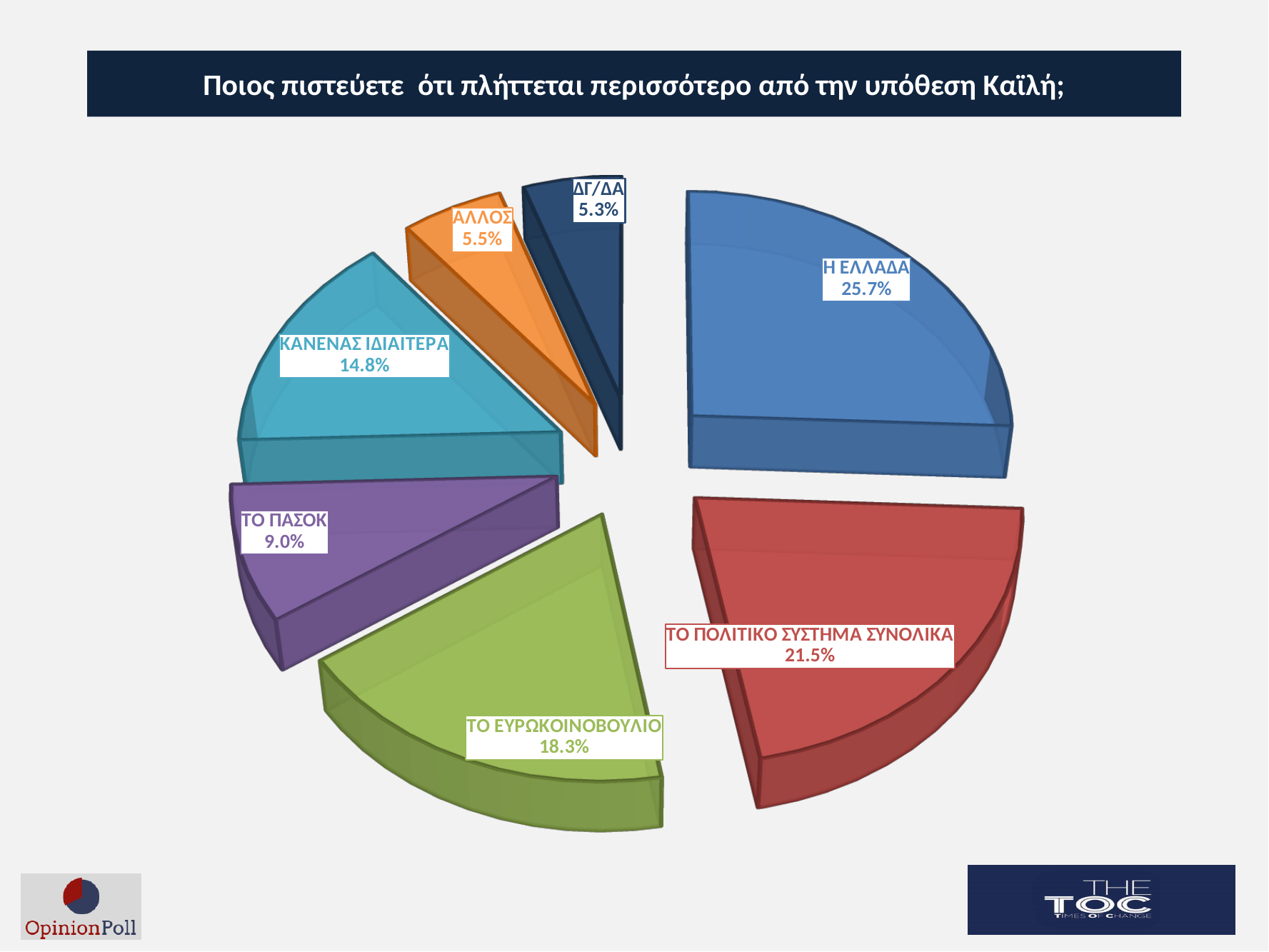
Which is larger, the slice for ΑΛΛΟΣ or the slice for ΔΓ/ΔΑ? ΑΛΛΟΣ What kind of chart is shown on the slide? Pie chart What percentage of the pie is labelled for Η ΕΛΛΑΔΑ? 25.7% What value is shown for ΤΟ ΕΥΡΩΚΟΙΝΟΒΟΥΛΙΟ? 18.3% How many slices does the pie chart have? 7 What share of the pie does ΤΟ ΠΟΛΙΤΙΚΟ ΣΥΣΤΗΜΑ ΣΥΝΟΛΙΚΑ represent? 21.5% Which category has the smallest slice of the pie? ΔΓ/ΔΑ Which category has the largest slice of the pie? Η ΕΛΛΑΔΑ What is the difference in percentage points between ΤΟ ΕΥΡΩΚΟΙΝΟΒΟΥΛΙΟ and ΚΑΝΕΝΑΣ ΙΔΙΑΙΤΕΡΑ? 3.5 What is the difference in percentage points between Η ΕΛΛΑΔΑ and ΤΟ ΠΟΛΙΤΙΚΟ ΣΥΣΤΗΜΑ ΣΥΝΟΛΙΚΑ? 4.2 What value is shown for ΚΑΝΕΝΑΣ ΙΔΙΑΙΤΕΡΑ? 14.8% What value is shown for ΤΟ ΠΑΣΟΚ? 9.0%